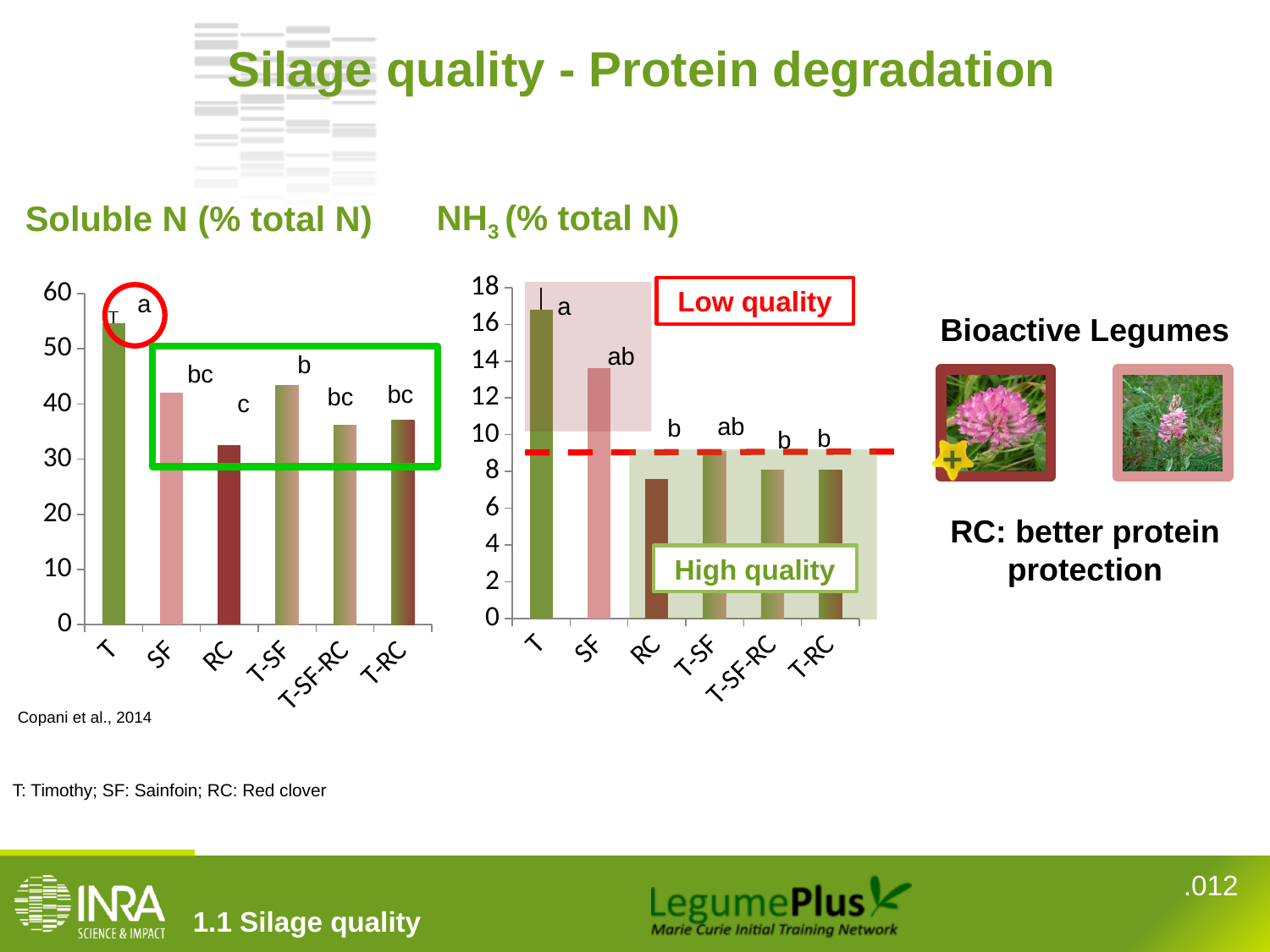
In the Soluble N (% total N) chart, is the value for T greater or less than 50? greater In the Soluble N (% total N) chart, what letter is printed above the T bar? a In the Soluble N (% total N) chart, which is larger, the value for T or the value for SF? T In the NH3 (% total N) chart, which is larger, the value for SF or the value for RC? SF In the Soluble N (% total N) chart, is the value for T-SF-RC greater or less than 40? less In the Soluble N (% total N) chart, which category has the highest value? T How many categories are shown on the x axis of the NH3 (% total N) chart? 6 In the NH3 (% total N) chart, is the value for T greater or less than 16? greater What kind of chart is the Soluble N (% total N) chart? bar chart In the Soluble N (% total N) chart, which category has the lowest value? RC In the NH3 (% total N) chart, which category has the highest value? T